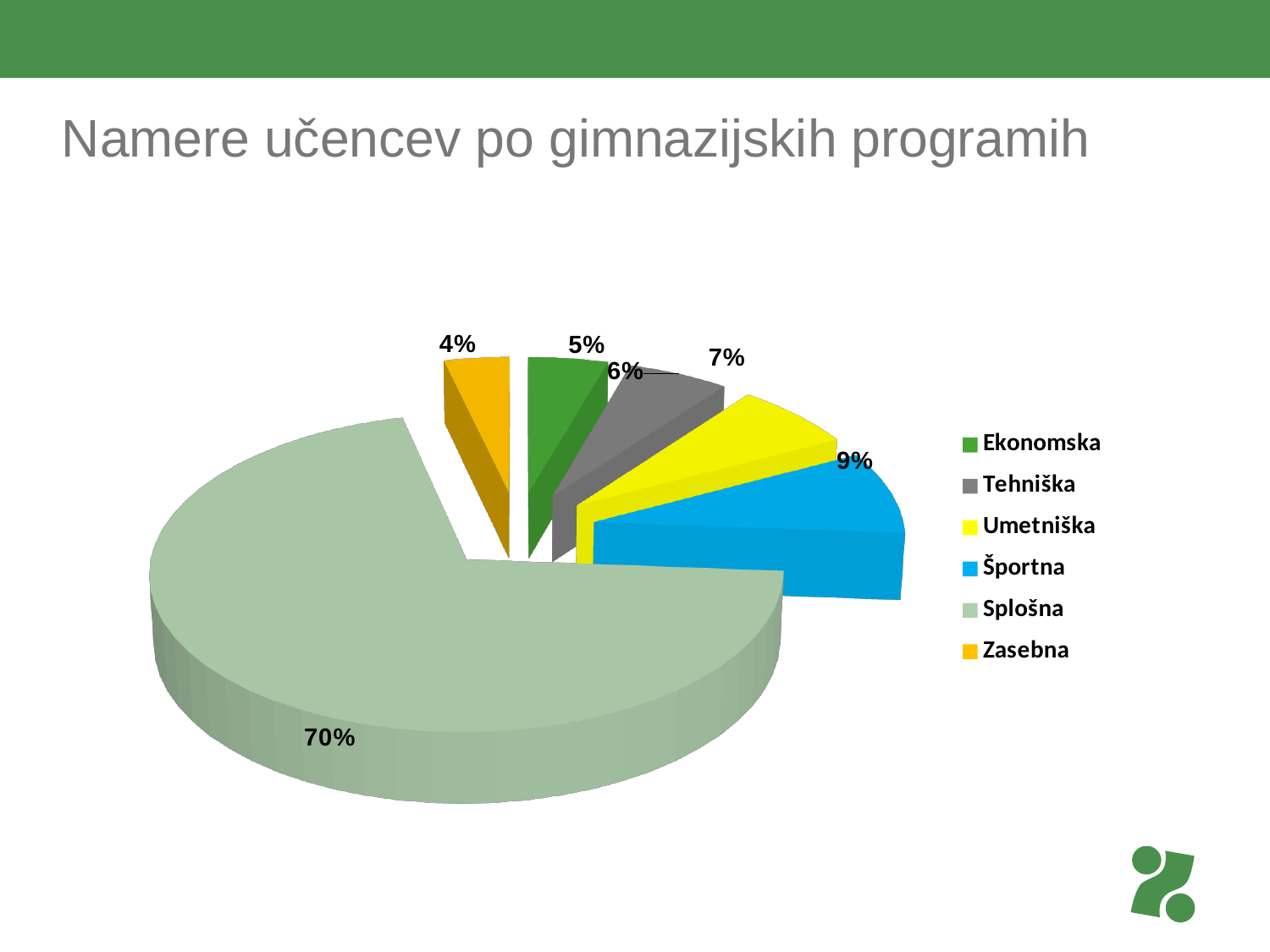
What is the value shown for Tehniška? 6% Which program has the smallest slice of the pie? Zasebna How many categories does the pie chart show? 6 What is the difference between the shares of Športna and Umetniška? 2% What share of the pie does Splošna have? 70% What is the value shown for Športna? 9% What is the title of the slide? Namere učencev po gimnazijskih programih What kind of chart is shown on the slide? Pie chart What is the value shown for Zasebna? 4% What is the value shown for Ekonomska? 5% Which program has the largest slice of the pie? Splošna Which has a larger share, Umetniška or Tehniška? Umetniška